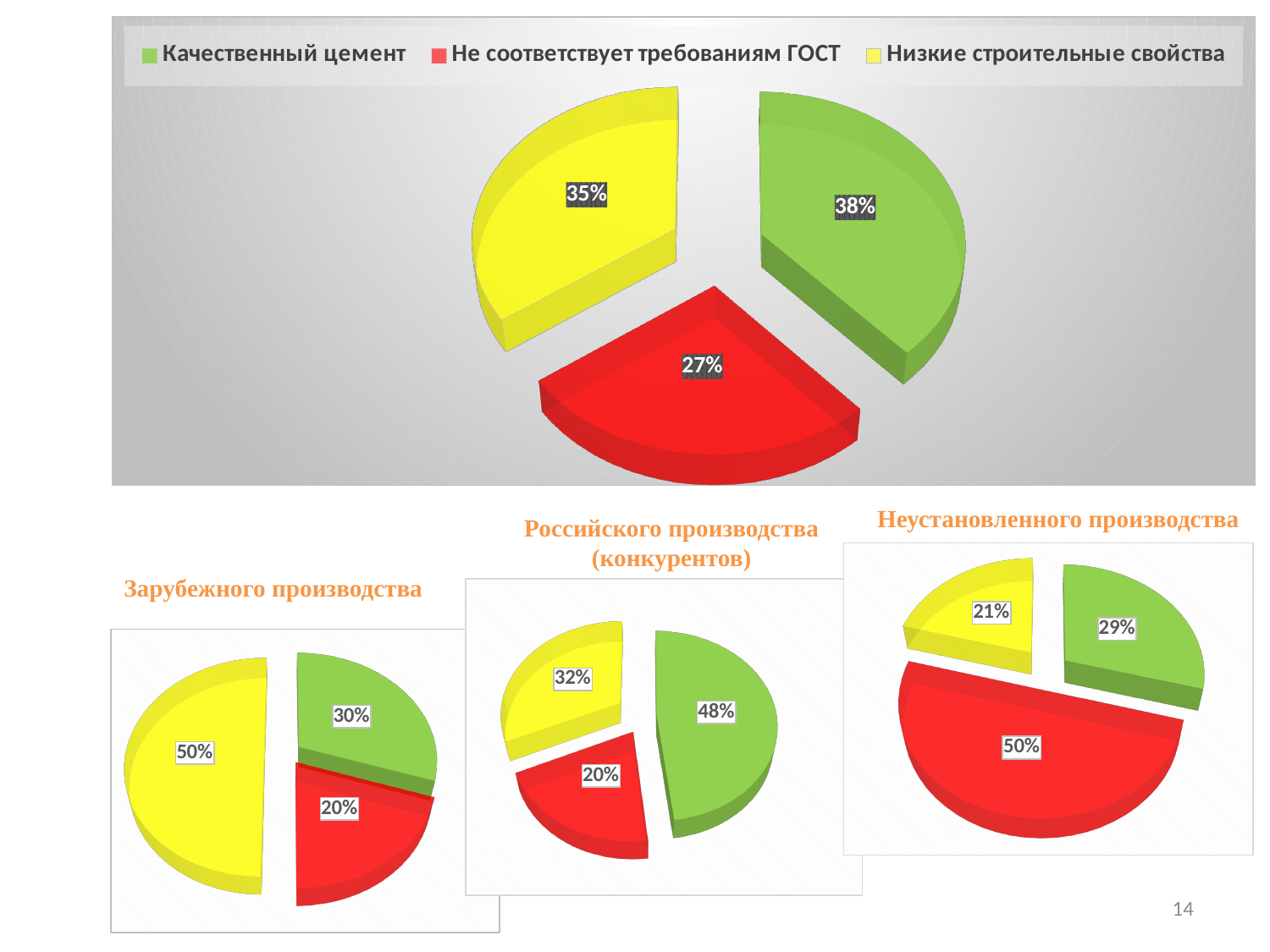
In the 'Российского производства (конкурентов)' pie chart, which category has the smallest slice? Не соответствует требованиям ГОСТ (20%) In the 'Зарубежного производства' pie chart, what share is labelled for the yellow slice (Низкие строительные свойства)? 50% In the large pie chart at the top of the slide, what share is labelled for Качественный цемент (green)? 38% In the 'Неустановленного производства' pie chart, what is the difference between the green slice (29%) and the yellow slice (21%)? 8% In the large pie chart at the top of the slide, what share is labelled for Не соответствует требованиям ГОСТ (red)? 27% In the 'Неустановленного производства' pie chart, what share is labelled for the red slice (Не соответствует требованиям ГОСТ)? 50% What type of chart is used for the 'Зарубежного производства' chart? Pie chart In the large pie chart at the top of the slide, what is the difference between the green slice (38%) and the yellow slice (35%)? 3% In the 'Российского производства (конкурентов)' pie chart, what share is labelled for the green slice (Качественный цемент)? 48% In the large pie chart at the top of the slide, which category has the smallest slice? Не соответствует требованиям ГОСТ How many entries does the legend at the top of the slide list? 3 In the 'Зарубежного производства' pie chart, which is larger: the green slice or the red slice? Green slice (30%)